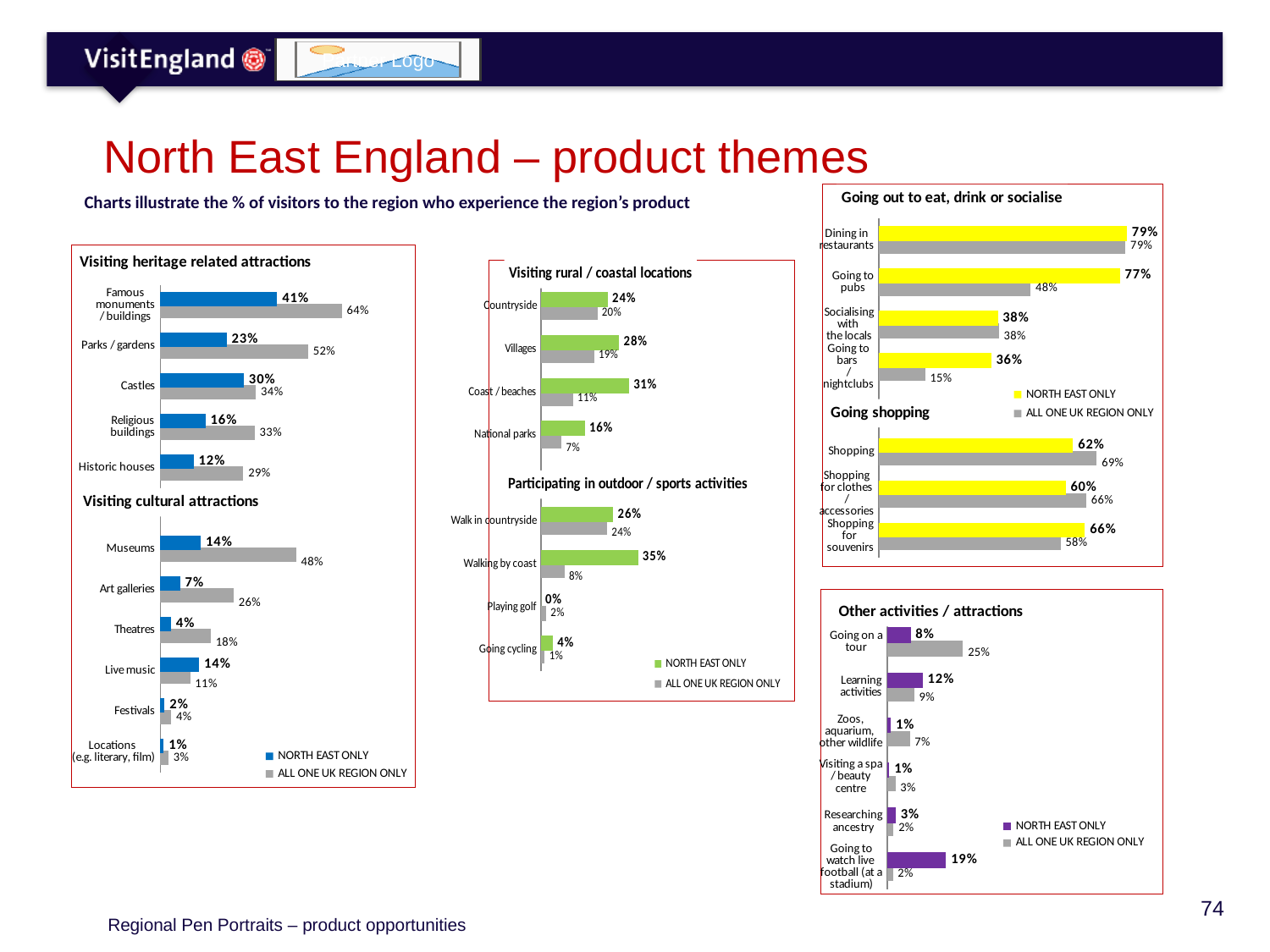
In the 'Visiting rural / coastal locations' chart, what is the ALL ONE UK REGION ONLY value for National parks? 7% In the 'Visiting cultural attractions' chart, how many categories are shown? 6 In the 'Visiting heritage related attractions' chart, what is the ALL ONE UK REGION ONLY value for Famous monuments / buildings? 64% How many series does the legend of the 'Other activities / attractions' chart list? 2 In the 'Going out to eat, drink or socialise' chart, what is the NORTH EAST ONLY value for Going to pubs? 77% In the 'Other activities / attractions' chart, what is the NORTH EAST ONLY value for Going to watch live football (at a stadium)? 19% In the 'Visiting cultural attractions' chart, what is the difference between the ALL ONE UK REGION ONLY and NORTH EAST ONLY values for Museums? 34% In the 'Visiting heritage related attractions' chart, what is the NORTH EAST ONLY value for Castles? 30% In the 'Participating in outdoor / sports activities' chart, which is larger for Walking by coast: the NORTH EAST ONLY value or the ALL ONE UK REGION ONLY value? NORTH EAST ONLY In the 'Visiting rural / coastal locations' chart, which category has the highest NORTH EAST ONLY value? Coast / beaches In the 'Visiting heritage related attractions' chart, which category has the lowest NORTH EAST ONLY value? Historic houses In the 'Going shopping' chart, what is the difference between the NORTH EAST ONLY and ALL ONE UK REGION ONLY values for Shopping for souvenirs? 8%